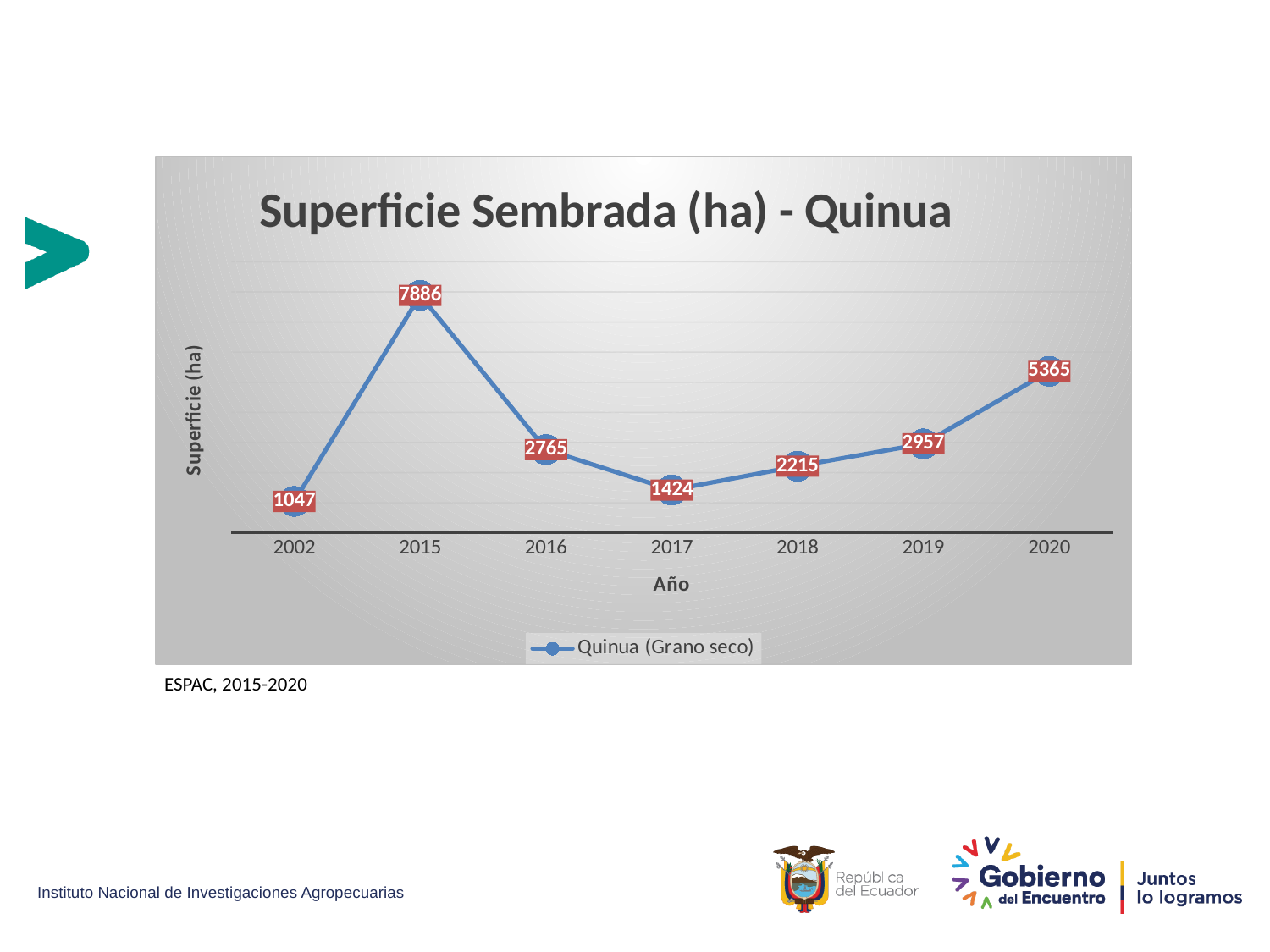
How many series does the legend list? 1 Which year has the highest value? 2015 What is the value for 2017? 1424 Which year has the lowest value? 2002 Which is larger, the value for 2016 or the value for 2018? 2016 What is the difference between the values for 2020 and 2019? 2408 What kind of chart is this? line chart What is the value for 2020? 5365 What is the value for 2015? 7886 Do the values rise or fall from 2017 to 2020? rise How many years are plotted on the x axis? 7 What is the difference between the values for 2015 and 2016? 5121